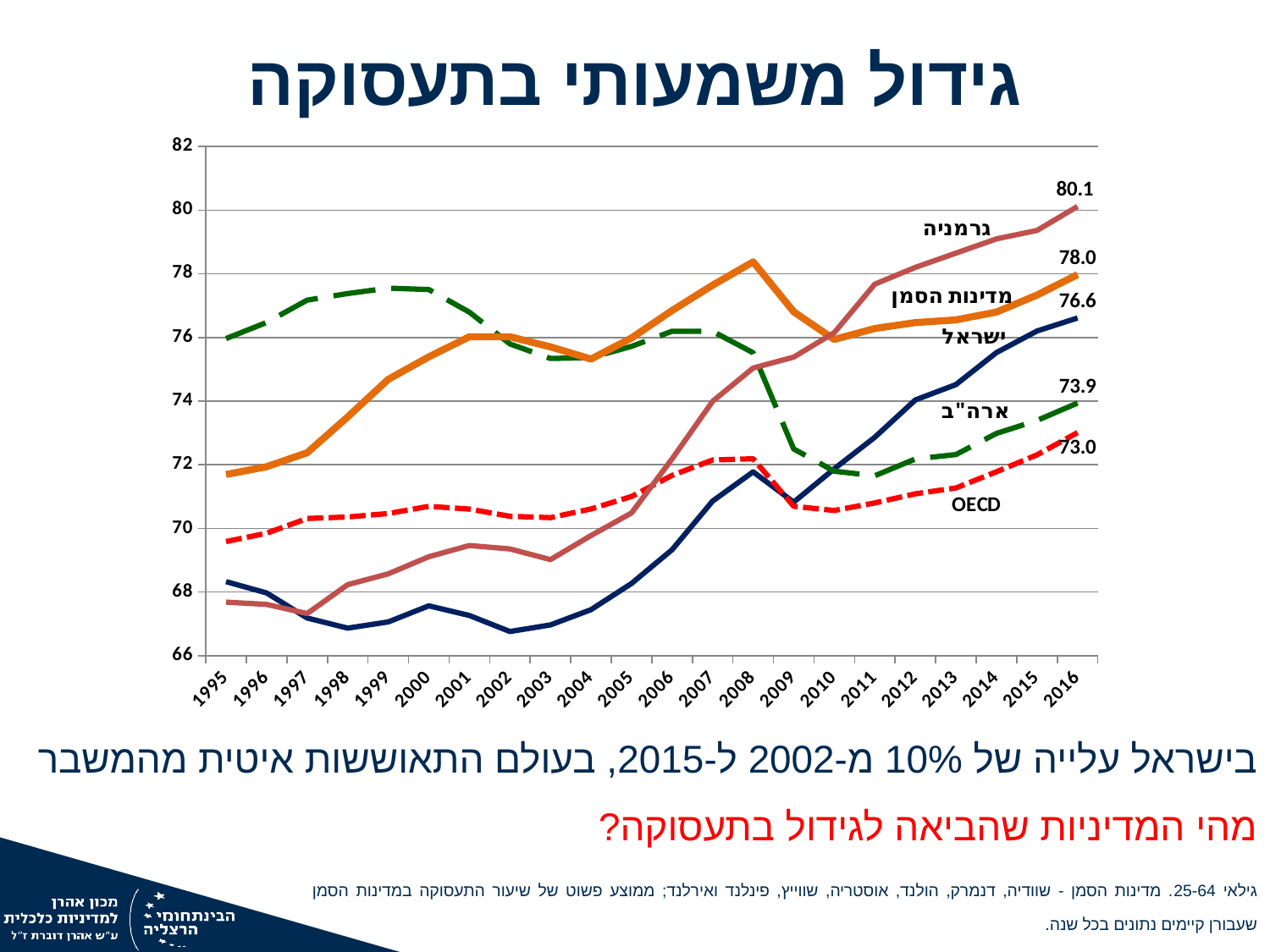
What is the value for ארה"ב (USA) in 2016? 73.9 Does the value for ישראל rise or fall between 2009 and 2016? rise Is the value for ישראל in 1995 greater or less than 70? less Which series has the highest value in 2016? גרמניה How many series are plotted on the chart? 5 What is the value for גרמניה (Germany) in 2016? 80.1 Which series has the lowest value in 2016? OECD What is the difference between the 2016 values of גרמניה and ישראל? 3.5 What is the value for the OECD line in 2016? 73.0 Which is larger in 2016: the value for מדינות הסמן or the value for ארה"ב? מדינות הסמן What type of chart is shown on the slide? line chart What is the value for ישראל (Israel) in 2016? 76.6